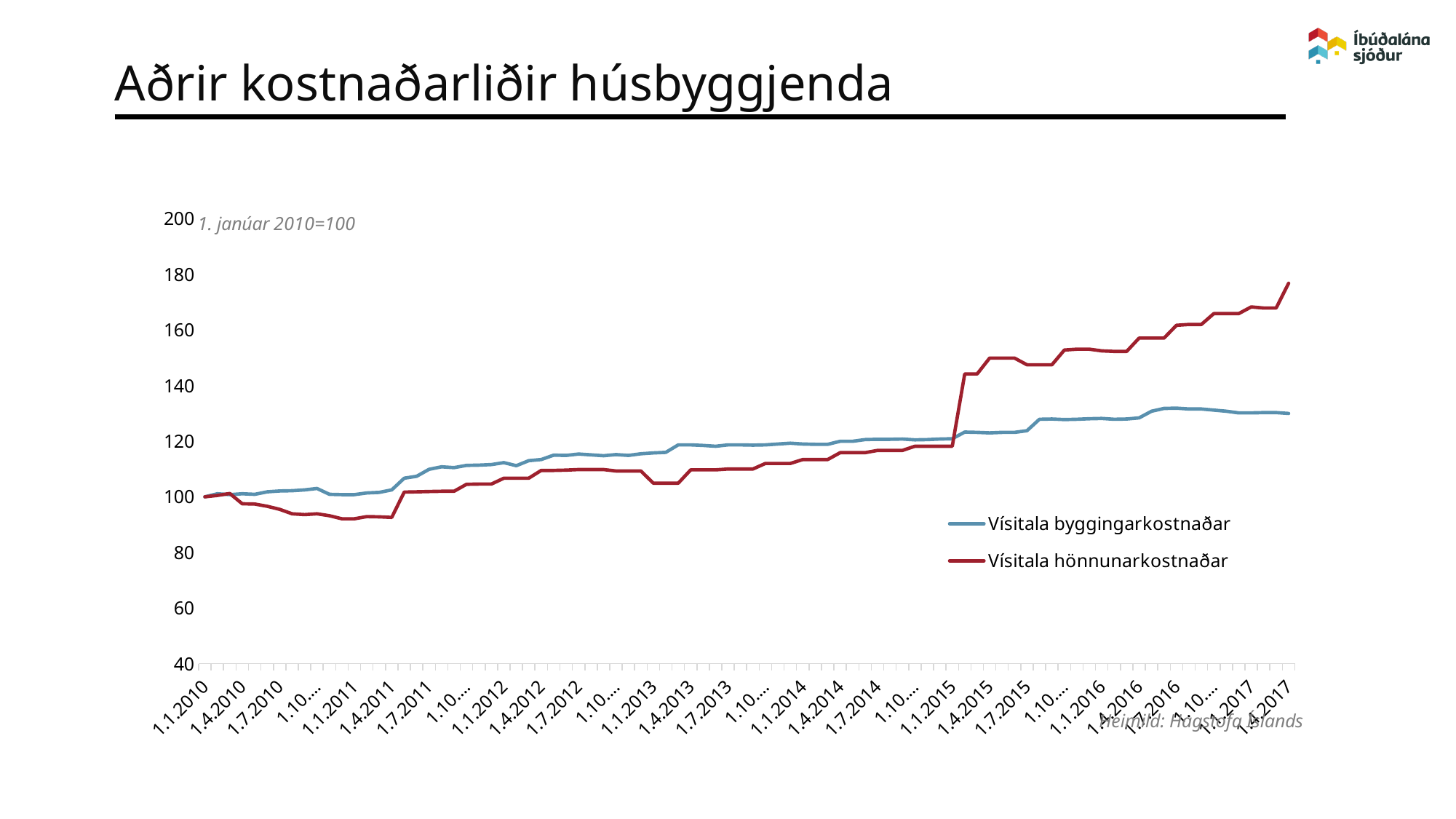
Is the value of Vísitala hönnunarkostnaðar at 1.1.2011 greater or less than 100? less Is the value of Vísitala hönnunarkostnaðar at 1.4.2015 greater or less than 140? greater What kind of chart is shown on the slide? line chart What colour is the line for Vísitala hönnunarkostnaðar? red Which series has the higher value at 1.1.2011, Vísitala byggingarkostnaðar or Vísitala hönnunarkostnaðar? Vísitala byggingarkostnaðar Is the value of Vísitala hönnunarkostnaðar at 1.1.2017 greater or less than 160? greater What is the value of Vísitala byggingarkostnaðar at 1.1.2010? 100 Which series has the higher value at 1.1.2017, Vísitala byggingarkostnaðar or Vísitala hönnunarkostnaðar? Vísitala hönnunarkostnaðar Does Vísitala hönnunarkostnaðar rise or fall overall from 1.1.2010 to 1.1.2017? rise How many series does the legend list? 2 What is the title of the chart on the slide? Aðrir kostnaðarliðir húsbyggjenda